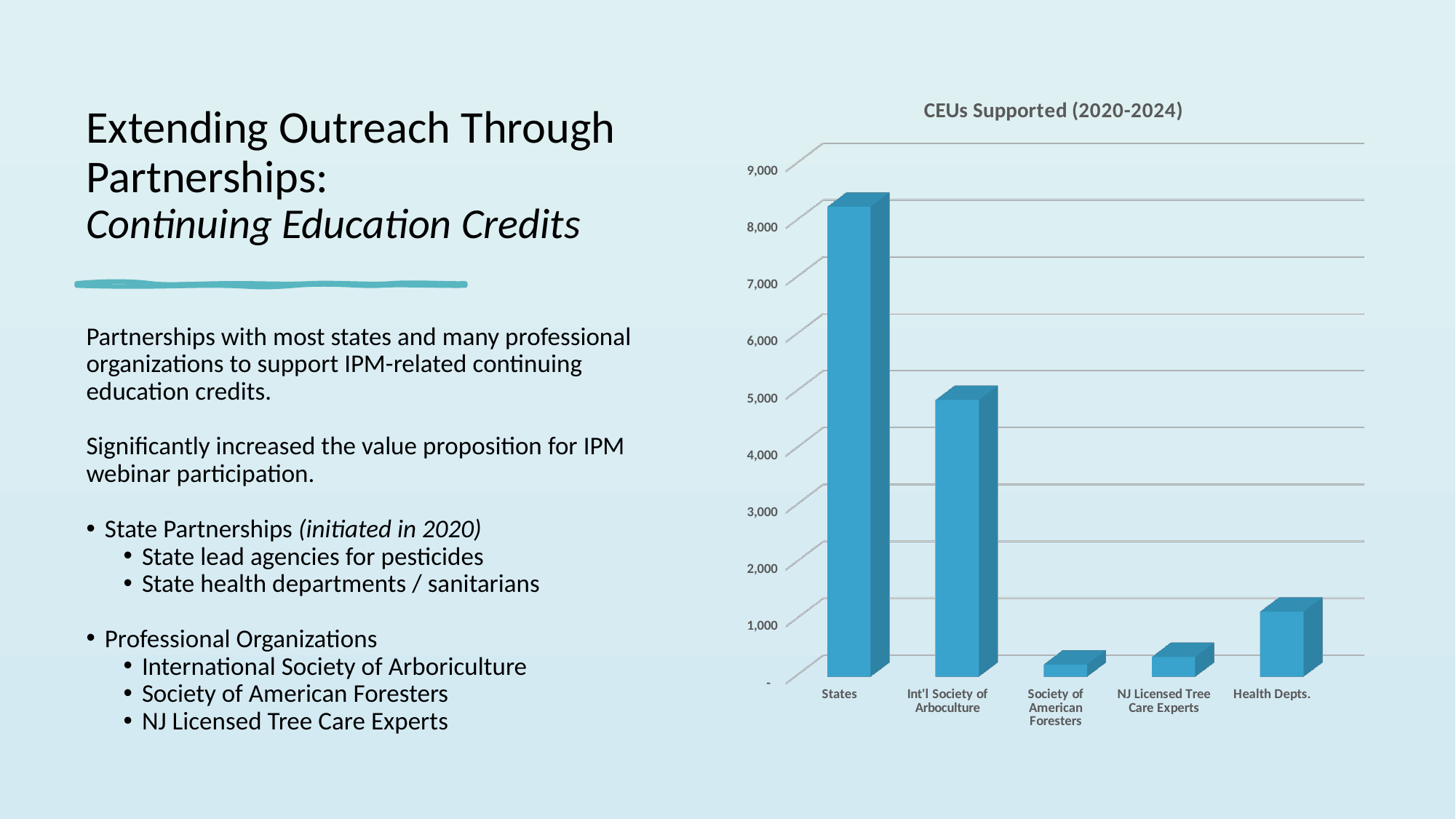
How many categories are shown on the x axis of the chart? 5 Which category has the lowest number of CEUs supported? Society of American Foresters Is the value for Society of American Foresters greater or less than 1,000? less Is the value for Int'l Society of Arboculture greater or less than 4,000? greater Which is larger, the value for States or the value for Int'l Society of Arboculture? States Is the value for Health Depts. greater or less than 2,000? less What is the title of the chart? CEUs Supported (2020-2024) Which is larger, the value for Health Depts. or the value for NJ Licensed Tree Care Experts? Health Depts. Which category has the highest number of CEUs supported? States What kind of chart is shown on the slide? bar chart